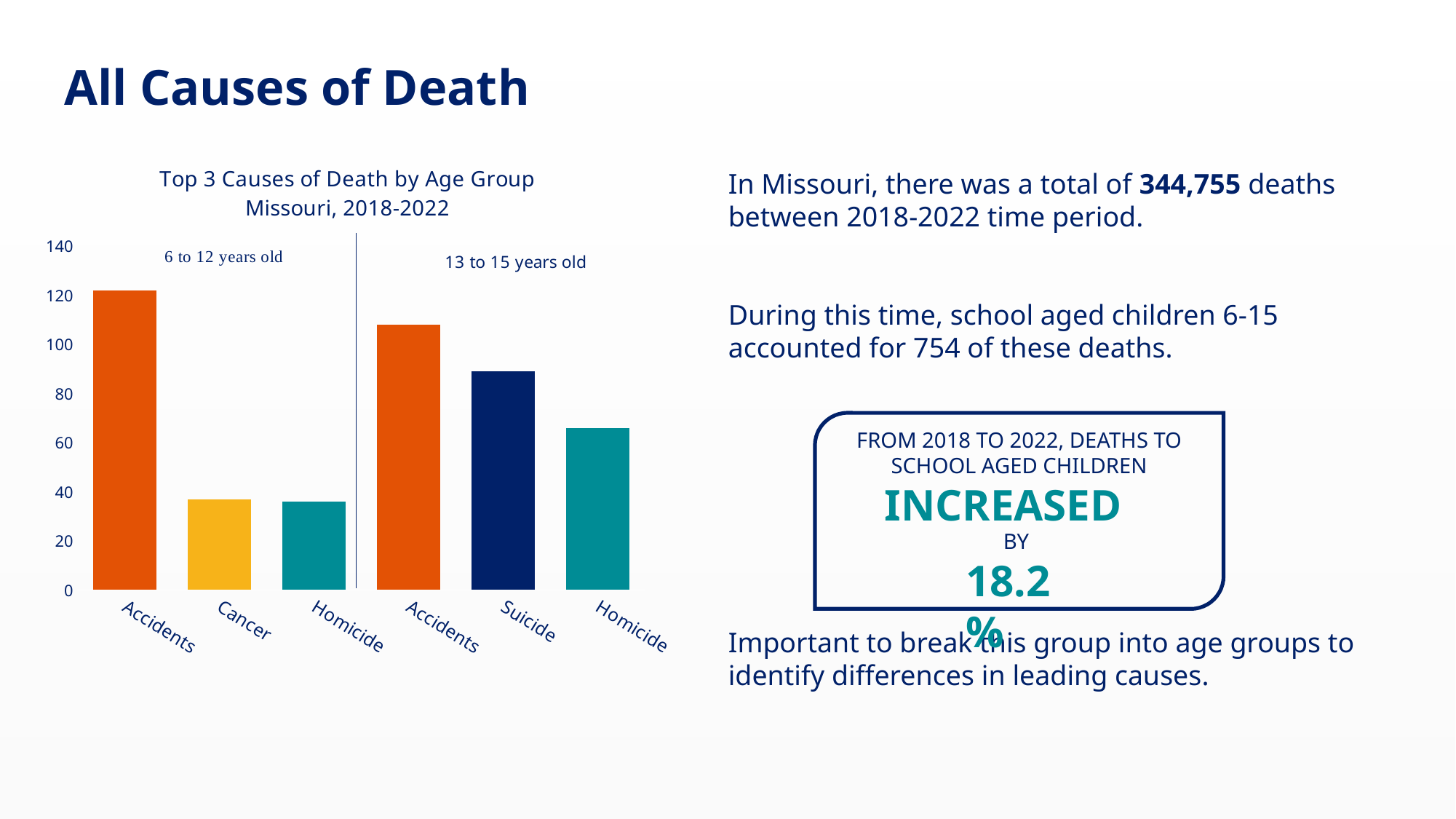
Which two age groups are shown in the chart? 6 to 12 years old and 13 to 15 years old Is the value for Cancer in the 6 to 12 years old group greater or less than 40? less Which cause of death has the tallest bar in the chart? Accidents (6 to 12 years old) Is the value for Accidents in the 13 to 15 years old group greater or less than 100? greater How many bars are plotted in the chart? 6 Which is larger: Accidents for 6 to 12 years old or Accidents for 13 to 15 years old? Accidents for 6 to 12 years old Which is larger: Homicide for 13 to 15 years old or Homicide for 6 to 12 years old? Homicide for 13 to 15 years old Is the value for Suicide in the 13 to 15 years old group greater or less than 80? greater What is the title of the chart? Top 3 Causes of Death by Age Group Missouri, 2018-2022 What kind of chart is shown on the slide? bar chart